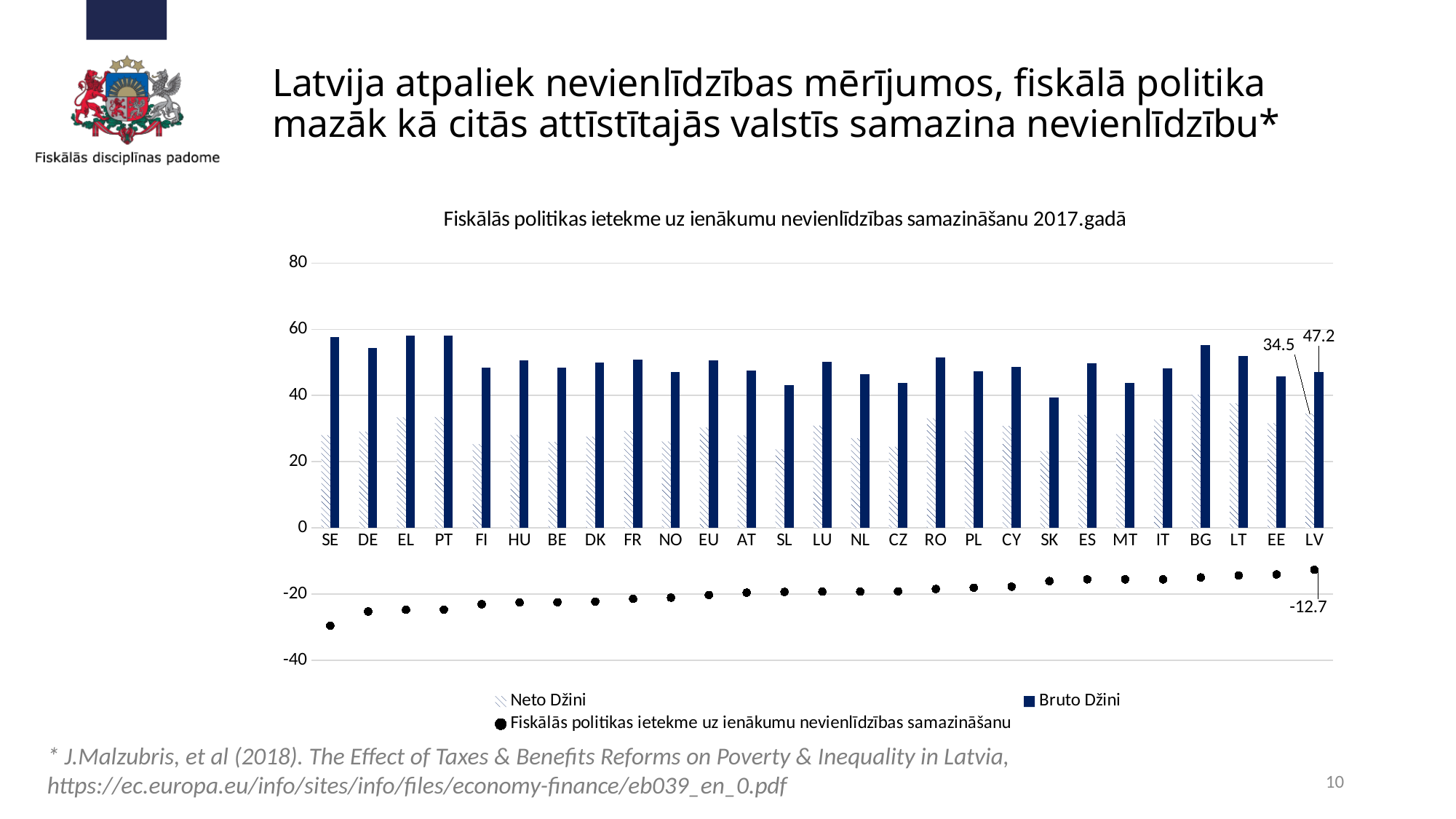
What is the difference between the Bruto Džini and Neto Džini values for LV? 12.7 Which country has the lowest value for 'Fiskālās politikas ietekme uz ienākumu nevienlīdzības samazināšanu'? SE Which country has the highest (closest to zero) value for 'Fiskālās politikas ietekme uz ienākumu nevienlīdzības samazināšanu'? LV What is the Neto Džini value for LV? 34.5 Which has a larger Neto Džini value, BG or SL? BG How many countries/categories are shown on the x axis? 27 How many series does the legend list? 3 What is the Bruto Džini value for LV? 47.2 Is the Neto Džini value for LT greater or less than 20? greater Is the Bruto Džini value for SE greater or less than 40? greater What is the value of 'Fiskālās politikas ietekme uz ienākumu nevienlīdzības samazināšanu' for LV? -12.7 Which country has the lowest Bruto Džini value? SK